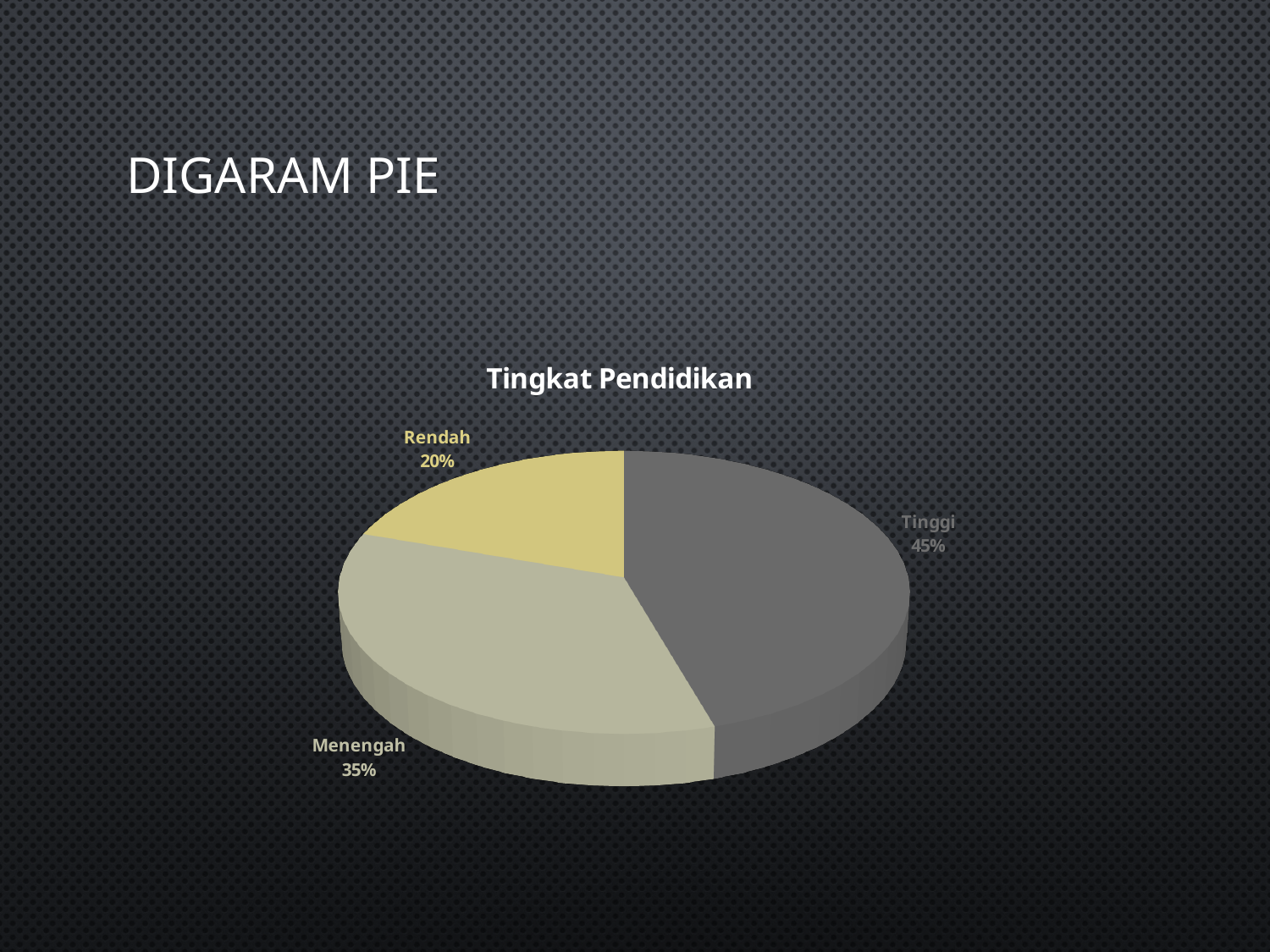
What percentage does the Tinggi slice represent? 45% What colour is the Rendah slice? yellow Which category has the largest share of the pie? Tinggi What is the title of the chart? Tingkat Pendidikan What percentage does the Menengah slice represent? 35% What is the difference in percentage points between Tinggi and Menengah? 10 Which category has the smallest share of the pie? Rendah What is the difference in percentage points between Menengah and Rendah? 15 How many slices does the pie chart have? 3 What type of chart is shown on the slide? pie chart What percentage does the Rendah slice represent? 20% Which is larger, the Menengah slice or the Rendah slice? Menengah